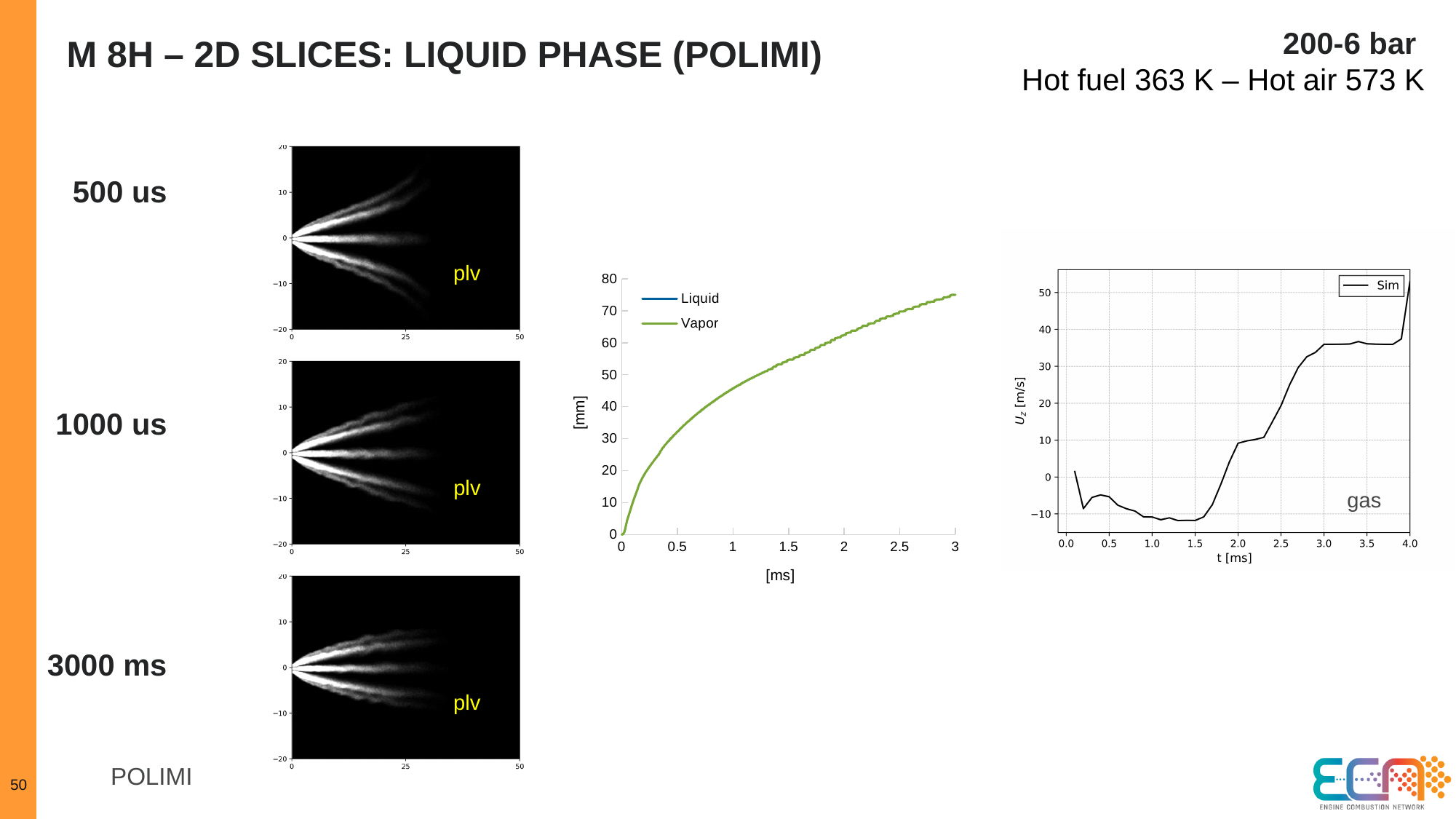
In the right chart, is the value at t = 4.0 ms greater or less than 40? greater How many series does the legend of the middle chart list? 2 What is the y-axis label of the right chart? Uz [m/s] In the right chart, is the value at t = 1.5 ms greater or less than 0? less In the right chart, which is larger: the value at t = 2.0 ms or the value at t = 3.0 ms? t = 3.0 ms What kind of chart is the middle chart with the [mm] axis? line chart In the middle chart, is the value at 1 ms greater or less than 40? greater How many series does the legend of the right chart list? 1 In the middle chart, do the values rise or fall as time increases along the x axis? rise What are the two legend entries of the middle chart? Liquid and Vapor